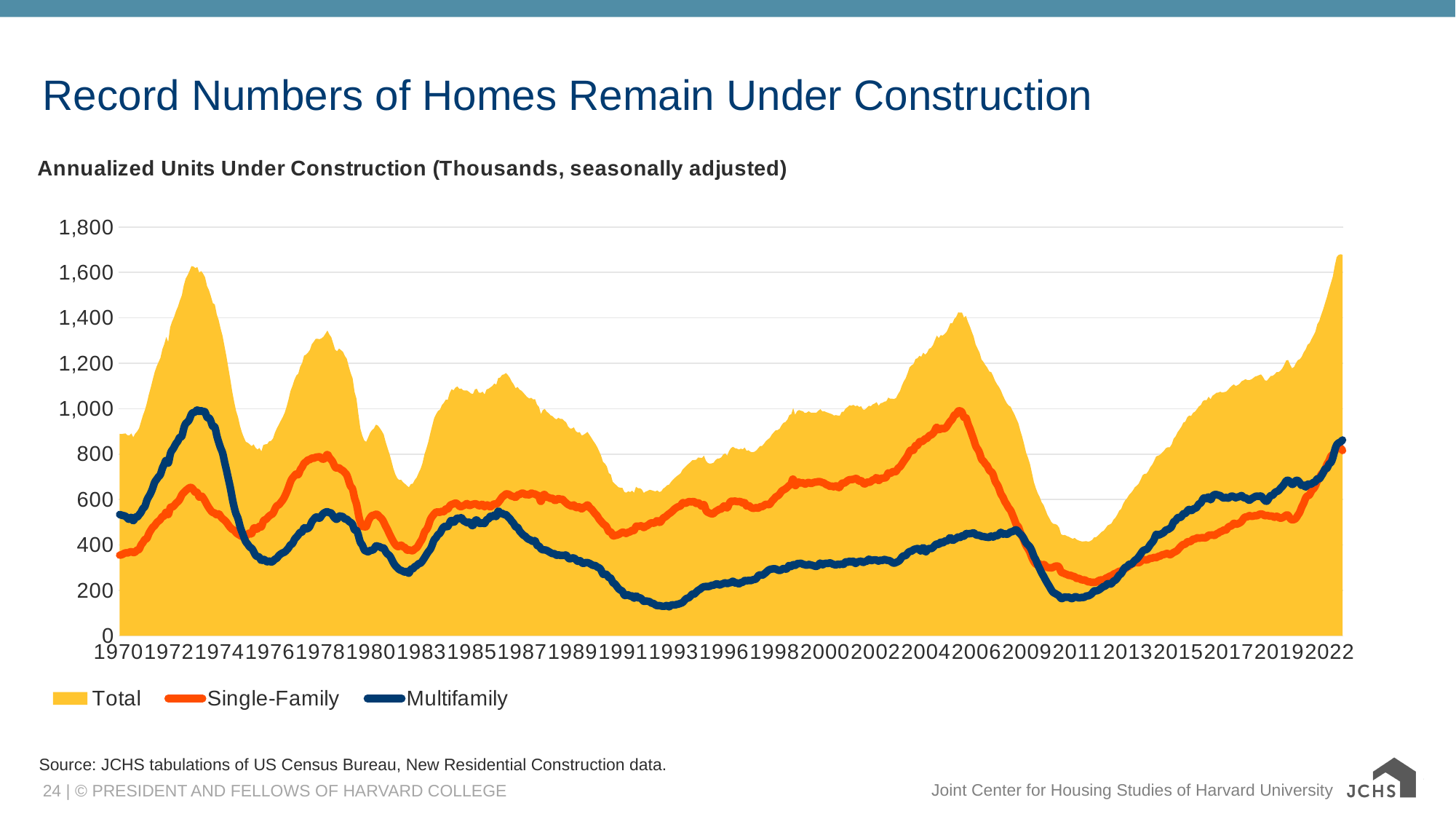
Is the value for Single-Family around 2011 greater or less than 400? less Does the Total series rise or fall from 2011 to 2022? rise Around 2005, which is larger, Single-Family or Multifamily? Single-Family Is the value for Multifamily around 1993 greater or less than 200? less Does the Single-Family series rise or fall from 2006 to 2009? fall What are the three series named in the legend? Total, Single-Family, Multifamily What is the title of the chart? Annualized Units Under Construction (Thousands, seasonally adjusted) Around 1972, which is larger, Multifamily or Single-Family? Multifamily Is the value for Total in 2022 greater or less than 1,600? greater How many series does the legend list? 3